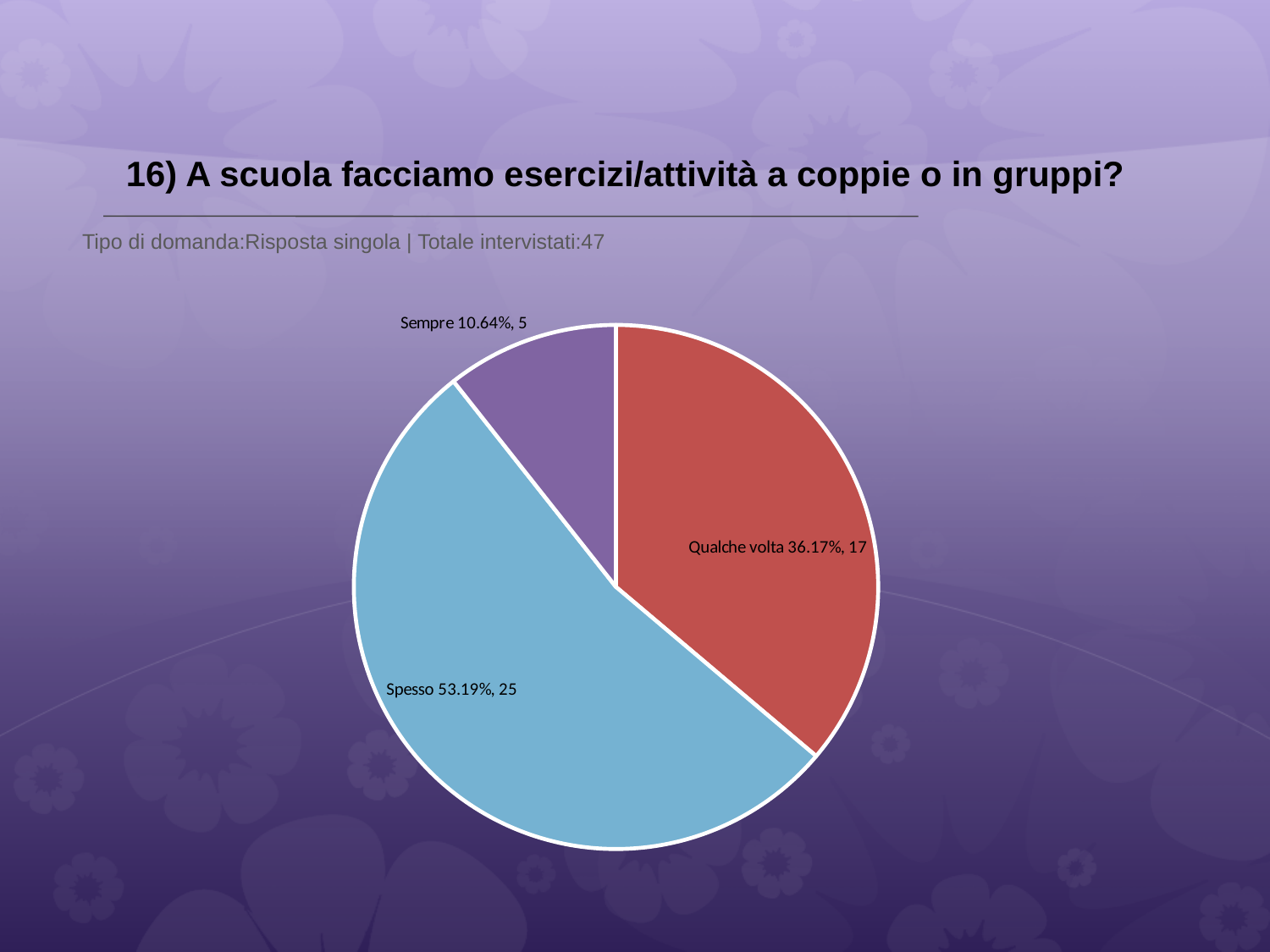
What is the difference in respondent count between "Spesso" and "Qualche volta"? 8 What kind of chart is shown on the slide? pie chart What percentage share does the "Sempre" slice have? 10.64% How many respondents answered "Spesso"? 25 How many respondents answered "Qualche volta"? 17 Which category has the largest slice of the pie? Spesso Which category has the smallest slice of the pie? Sempre Which slice is larger, "Qualche volta" or "Sempre"? Qualche volta What percentage share does the "Spesso" slice have? 53.19% How many respondents answered "Sempre"? 5 How many slices does the pie chart have? 3 What percentage share does the "Qualche volta" slice have? 36.17%